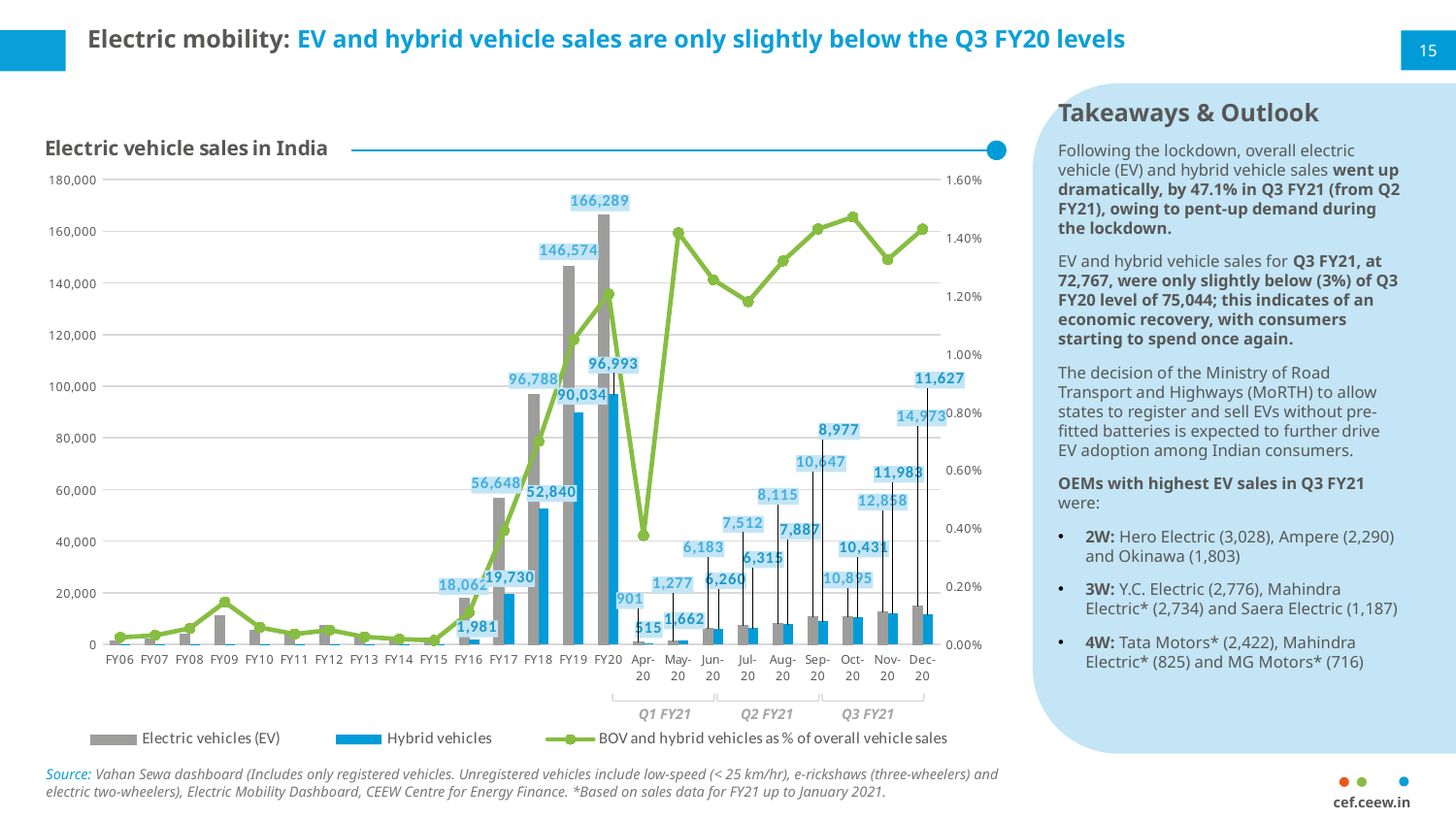
What type of chart is 'Electric vehicle sales in India'? Combination bar and line chart How many series does the legend of the 'Electric vehicle sales in India' chart list? 3 What is the difference between the Electric vehicles (EV) and Hybrid vehicles values for FY18? 43,948 What is the value of Electric vehicles (EV) for FY16? 18,062 What is the maximum value shown on the right-hand (percentage) axis of the chart? 1.60% What is the difference between the Electric vehicles (EV) values for FY20 and FY19? 19,715 Is the value of 'BOV and hybrid vehicles as % of overall vehicle sales' for Apr-20 greater or less than 0.60%? less What is the value of Hybrid vehicles for FY19? 90,034 How many categories are shown on the x axis of the 'Electric vehicle sales in India' chart? 24 What is the value of Electric vehicles (EV) for FY20? 166,289 Which category has the highest Electric vehicles (EV) value? FY20 Which is larger, the Hybrid vehicles value for FY17 or for FY18? FY18